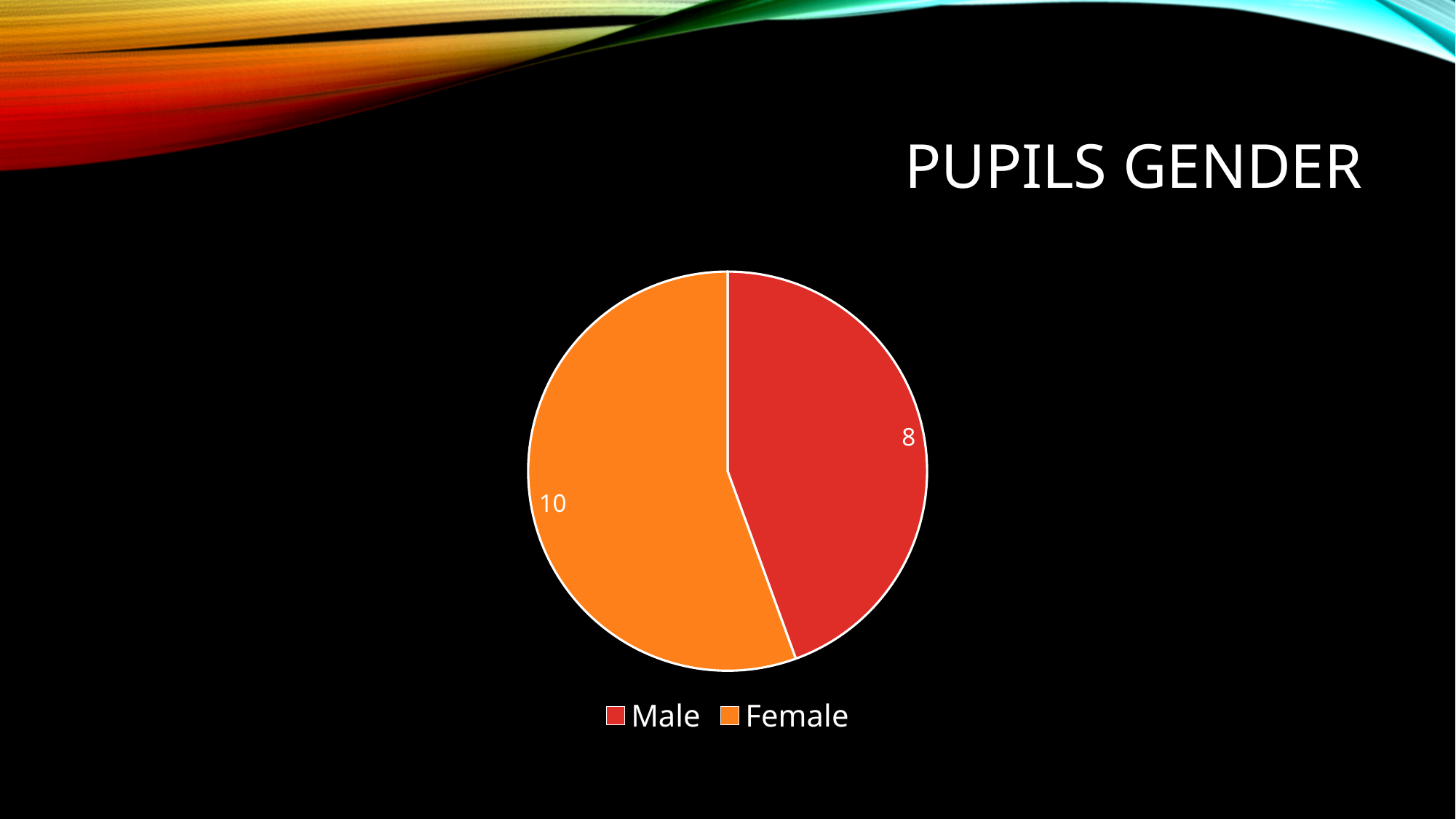
Which category has the smallest slice? Male How many slices does the pie chart have? 2 Which category has the largest slice? Female Which is larger, the value for Male or the value for Female? Female What is the total of all slices in the pie chart? 18 What is the title of the slide? PUPILS GENDER What colour is the Female slice? orange What kind of chart is shown on the slide? pie chart What is the difference between the Female and Male values? 2 What is the value for Female? 10 What is the value for Male? 8